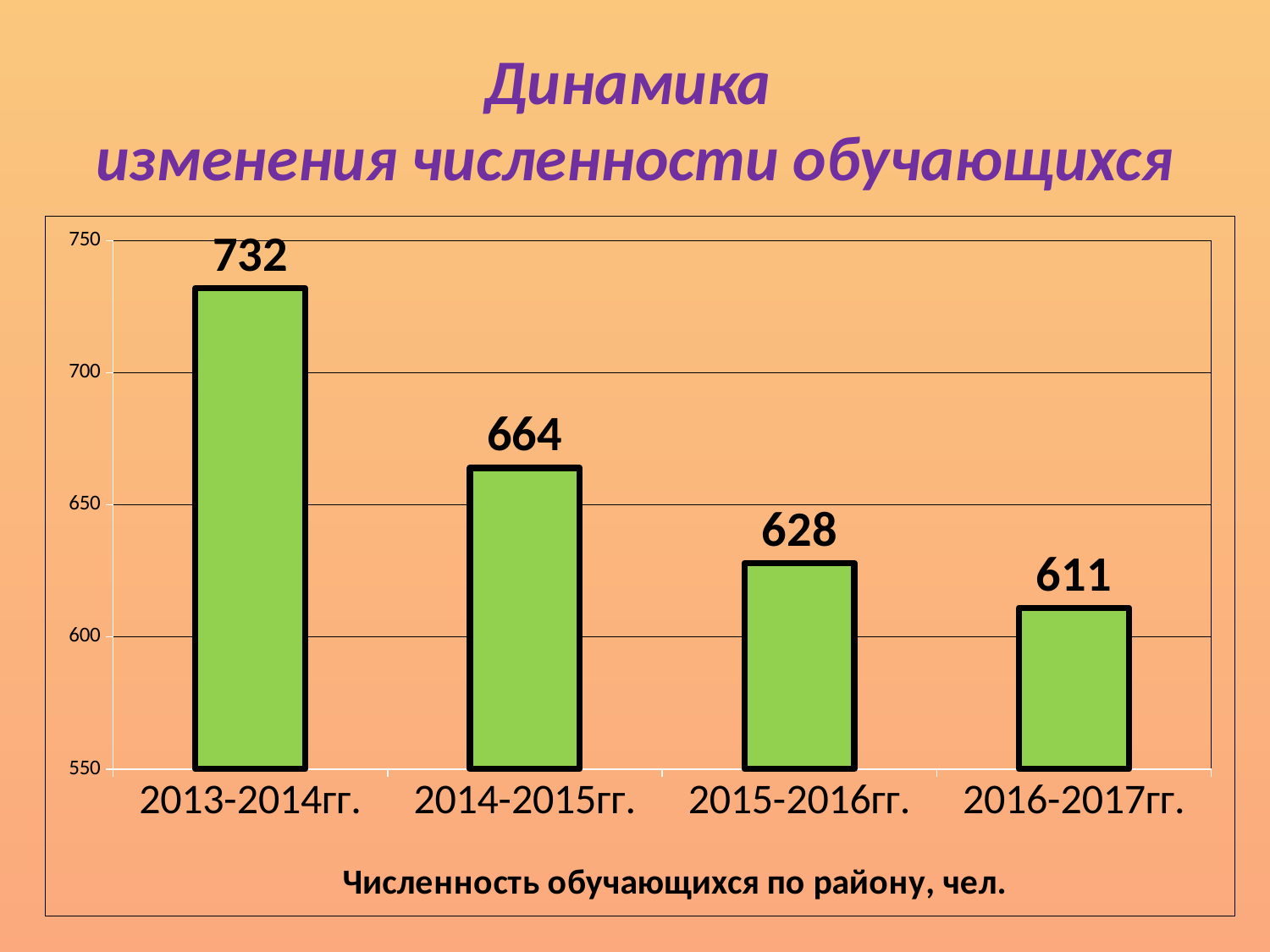
What is the number of students for 2013-2014гг.? 732 Which school year has the lowest number of students? 2016-2017гг. What kind of chart is shown on the slide? bar chart What is the number of students for 2015-2016гг.? 628 What is the difference between the values for 2013-2014гг. and 2016-2017гг.? 121 What is the difference between the values for 2014-2015гг. and 2015-2016гг.? 36 How many school years are shown on the chart? 4 Which is larger, the value for 2014-2015гг. or the value for 2015-2016гг.? 2014-2015гг. What is the number of students for 2014-2015гг.? 664 Which school year has the highest number of students? 2013-2014гг. What is the number of students for 2016-2017гг.? 611 Do the values rise or fall from 2013-2014гг. to 2016-2017гг.? fall